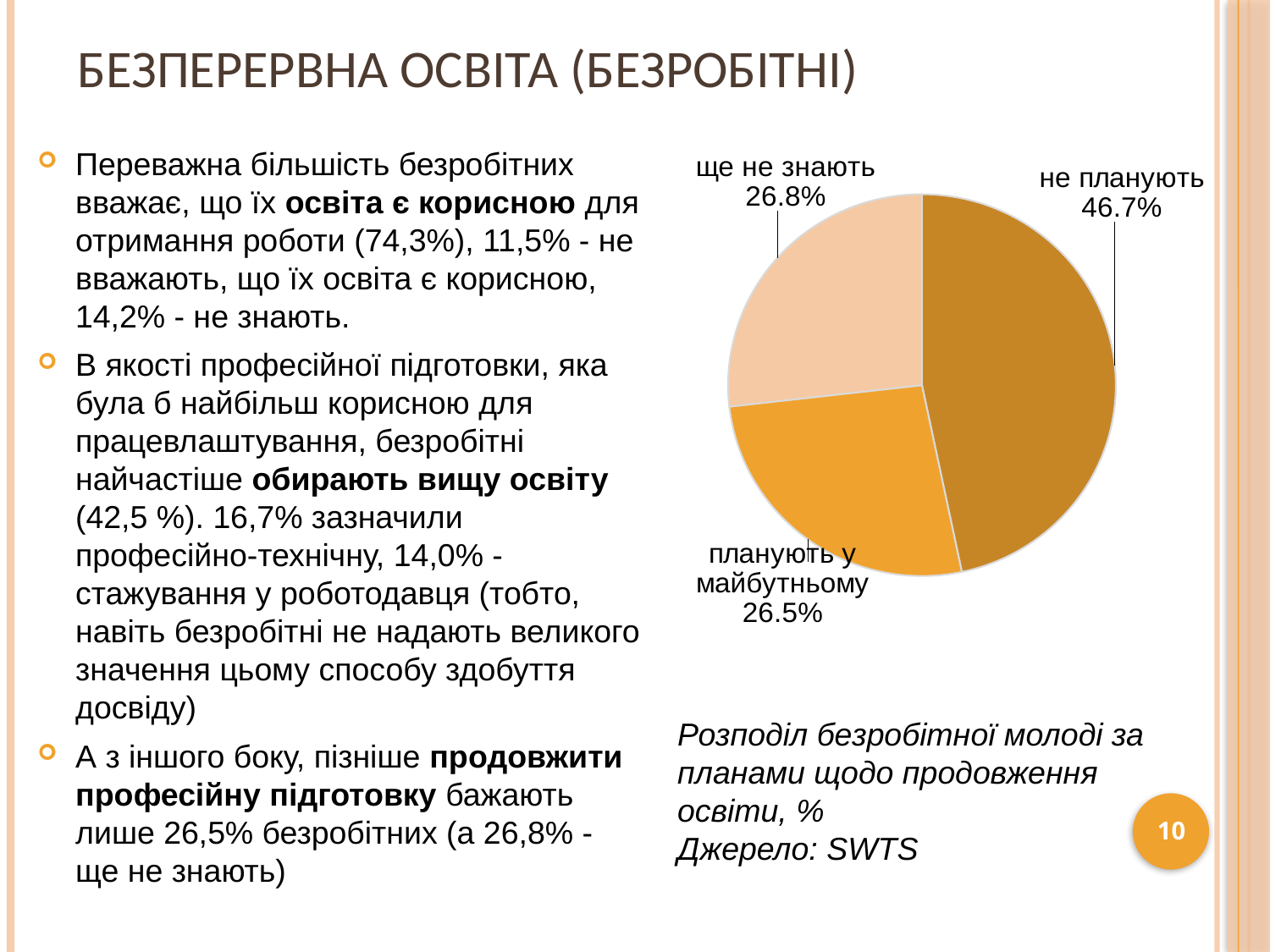
What percentage is shown for "планують у майбутньому"? 26.5% What percentage of unemployed youth is shown for "не планують"? 46.7% Which is larger: the slice for "не планують" or the slice for "ще не знають"? не планують How many slices does the pie chart have? 3 What share of the pie does the "не планують" slice represent? 46.7% What is the difference in percentage points between "не планують" (46.7%) and "ще не знають" (26.8%)? 19.9 What is the difference in percentage points between "не планують" (46.7%) and "планують у майбутньому" (26.5%)? 20.2 Which category has the largest slice of the pie? не планують What type of chart is shown on the slide? pie chart What is the caption (title) given for the pie chart? Розподіл безробітної молоді за планами щодо продовження освіти, % According to the caption, what is the source of the chart data? SWTS What percentage is shown for the "ще не знають" slice? 26.8%